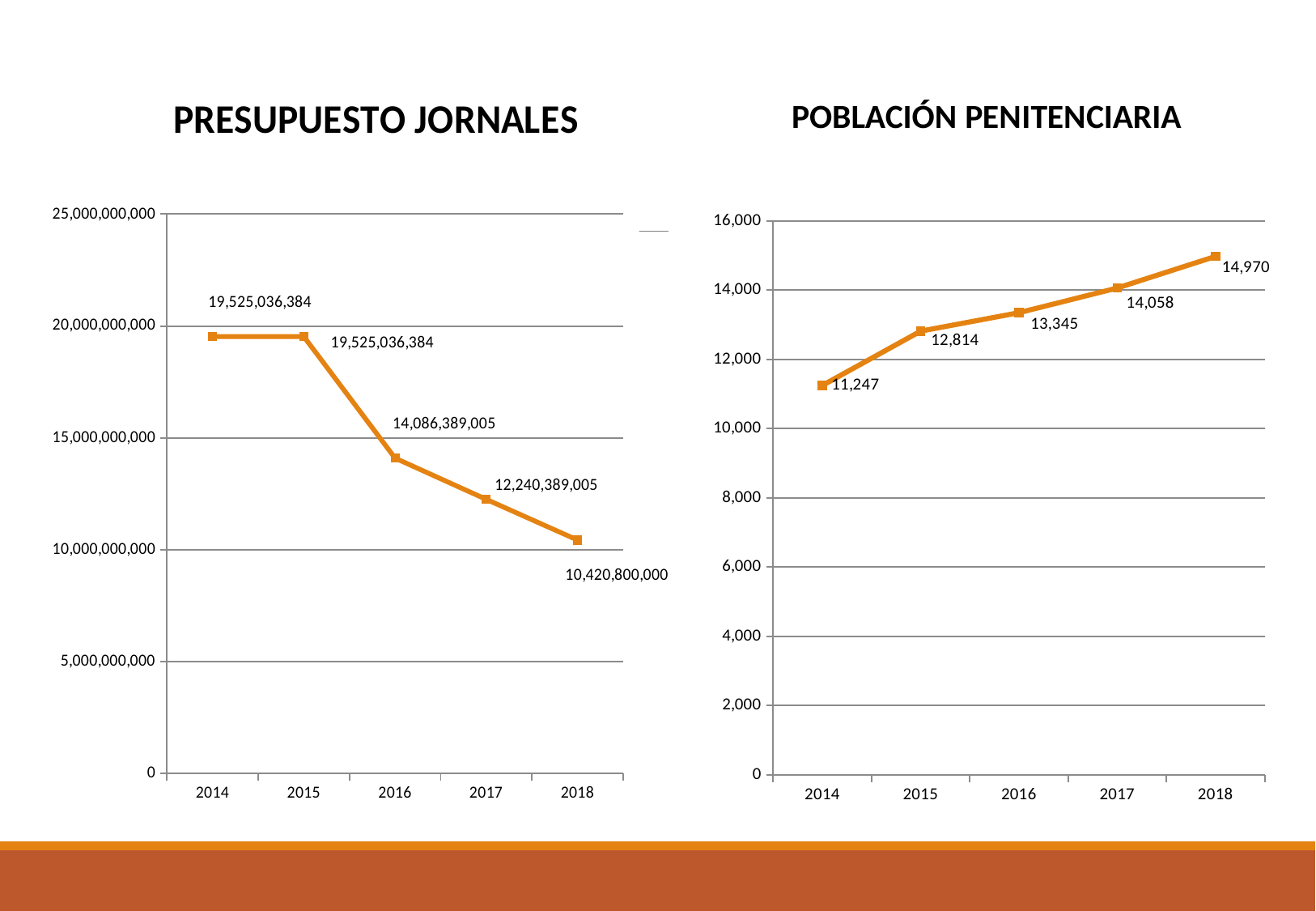
In the POBLACIÓN PENITENCIARIA chart, what is the difference between the 2018 and 2014 values? 3,723 What kind of chart is the POBLACIÓN PENITENCIARIA chart? line chart In the PRESUPUESTO JORNALES chart, what is the difference between the 2016 and 2017 values? 1,846,000,000 In the POBLACIÓN PENITENCIARIA chart, which year has the highest value? 2018 In the PRESUPUESTO JORNALES chart, do the values rise or fall from 2015 to 2018? fall In the POBLACIÓN PENITENCIARIA chart, what is the value for 2017? 14,058 In the POBLACIÓN PENITENCIARIA chart, what is the value for 2015? 12,814 In the POBLACIÓN PENITENCIARIA chart, do the values rise or fall from 2014 to 2018? rise In the PRESUPUESTO JORNALES chart, what is the value for 2018? 10,420,800,000 In the PRESUPUESTO JORNALES chart, which year has the lowest value? 2018 In the PRESUPUESTO JORNALES chart, what is the value for 2016? 14,086,389,005 In the PRESUPUESTO JORNALES chart, how many years are plotted? 5